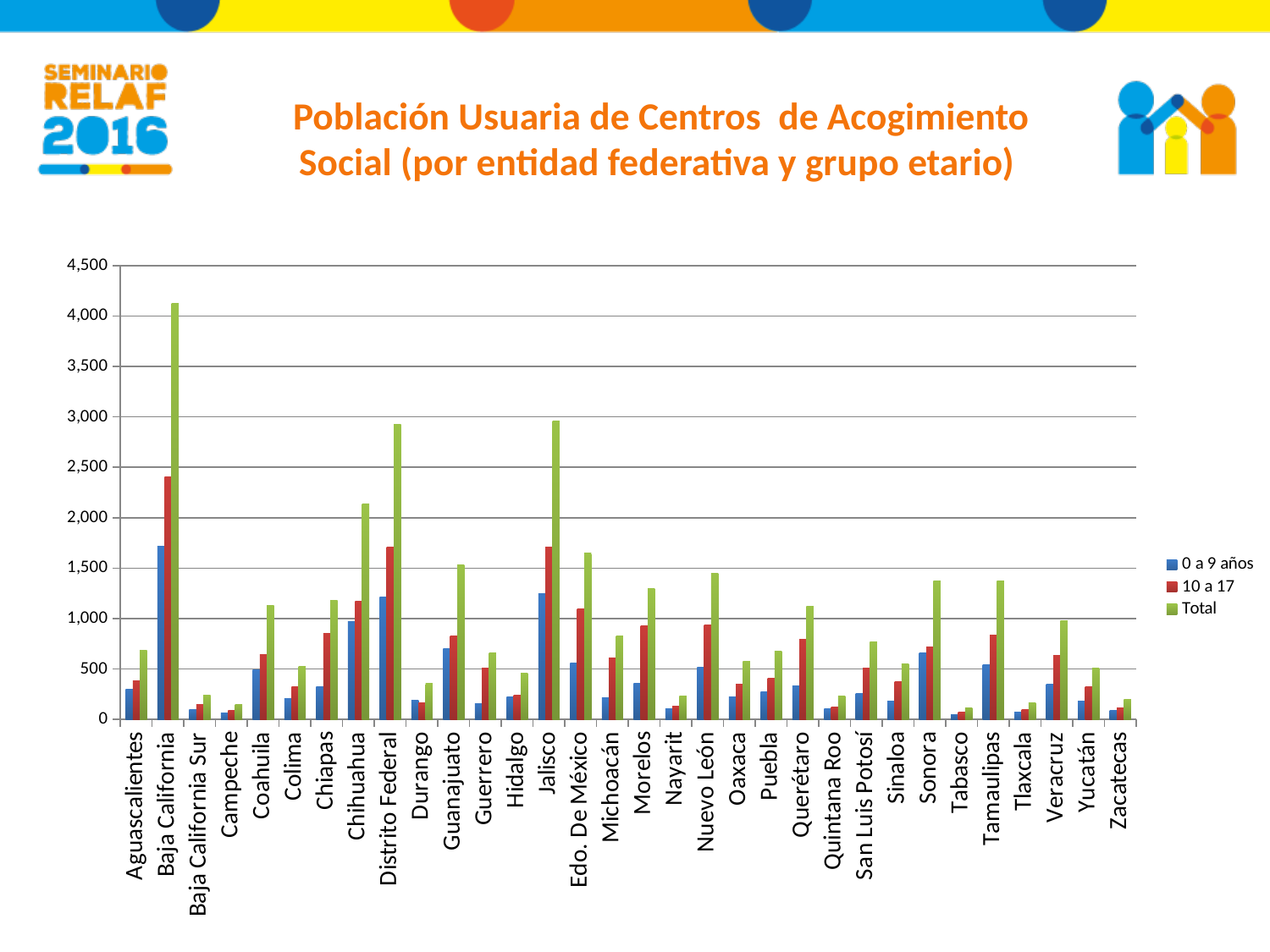
Is the '10 a 17' value for Baja California greater or less than 2,500? less Is the Total value for Chihuahua greater or less than 1,500? greater How many entidades federativas (categories) are shown on the x axis? 32 Which has the larger Total value, Chihuahua or Guanajuato? Chihuahua Which entidad federativa has the highest Total value? Baja California How many series does the legend list? 3 What kind of chart is shown on the slide? bar chart Is the Total value for Baja California greater or less than 4,000? greater What is the title of the chart? Población Usuaria de Centros de Acogimiento Social (por entidad federativa y grupo etario)